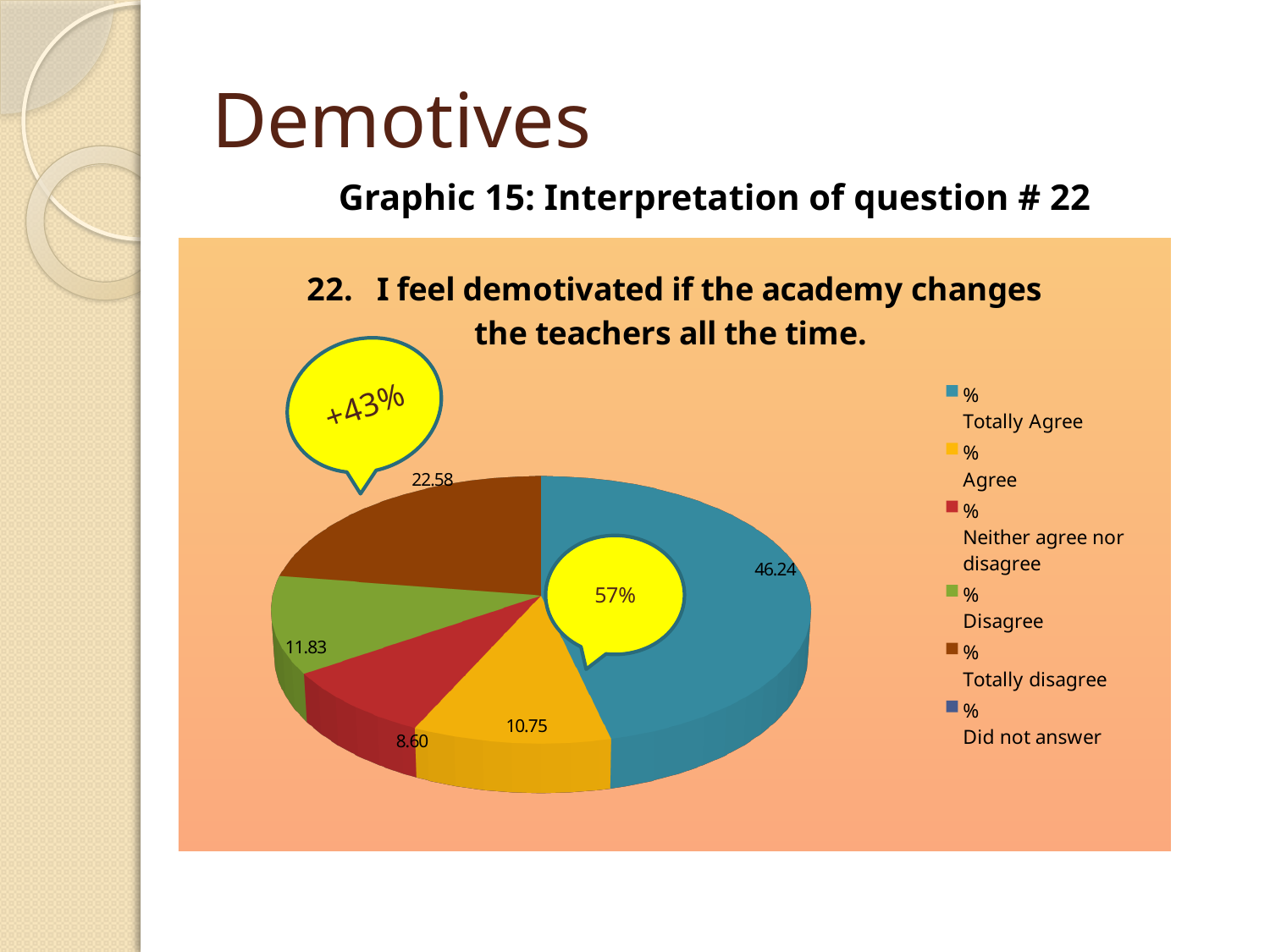
Which labelled response category has the smallest slice of the pie? Neither agree nor disagree What is the value shown for the Agree slice? 10.75 How many entries does the chart legend list? 6 Which is larger, the Disagree slice or the Agree slice? Disagree What kind of chart is shown on the slide? Pie chart What is the value shown for the Disagree slice? 11.83 What is the caption given above the chart? Graphic 15: Interpretation of question # 22 Which response category has the largest slice of the pie? Totally Agree What is the difference between the Totally Agree value and the Totally disagree value? 23.66 What is the value shown for the Neither agree nor disagree slice? 8.60 What is the value shown for the Totally Agree slice? 46.24 What is the value shown for the Totally disagree slice? 22.58